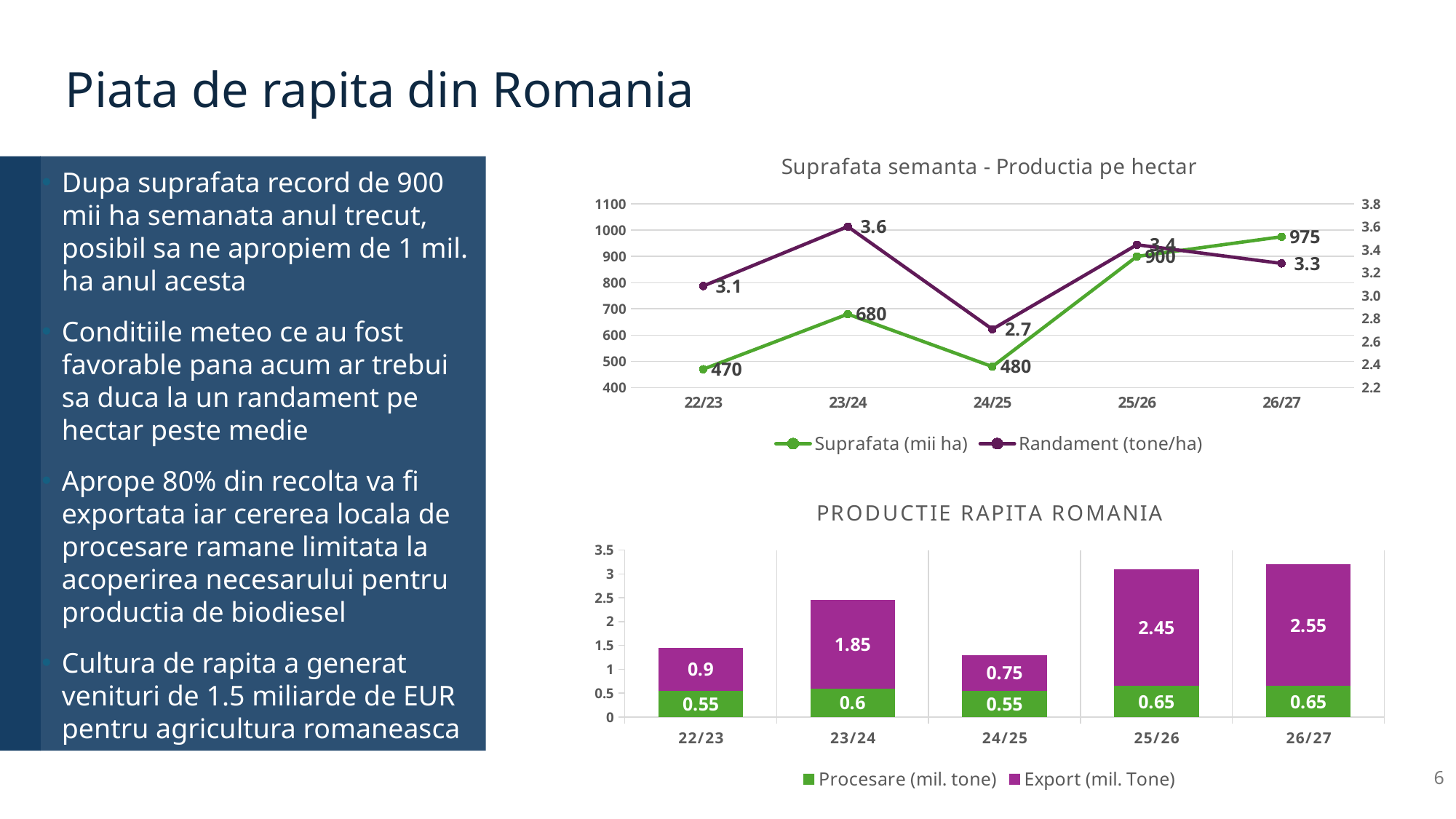
In the 'PRODUCTIE RAPITA ROMANIA' chart, is the Procesare (mil. tone) value for 23/24 larger or smaller than the Export (mil. Tone) value for 23/24? Smaller In the 'Suprafata semanta - Productia pe hectar' chart, what is the difference in Suprafata (mii ha) between 26/27 and 22/23? 505 In the 'PRODUCTIE RAPITA ROMANIA' chart, what is the Export (mil. Tone) value for 23/24? 1.85 In the 'Suprafata semanta - Productia pe hectar' chart, what is the Suprafata (mii ha) value for 25/26? 900 In the 'PRODUCTIE RAPITA ROMANIA' chart, what is the total of the stacked bar for 25/26? 3.1 In the 'Suprafata semanta - Productia pe hectar' chart, which season has the highest Randament (tone/ha)? 23/24 In the 'Suprafata semanta - Productia pe hectar' chart, which season has the lowest Suprafata (mii ha)? 22/23 In the 'Suprafata semanta - Productia pe hectar' chart, what is the Randament (tone/ha) value for 24/25? 2.7 What kind of chart is 'PRODUCTIE RAPITA ROMANIA'? Stacked bar chart In the 'Suprafata semanta - Productia pe hectar' chart, how many series does the legend list? 2 In the 'PRODUCTIE RAPITA ROMANIA' chart, which season has the lowest Export (mil. Tone) value? 24/25 How many seasons are shown on the x axis of the 'PRODUCTIE RAPITA ROMANIA' chart? 5